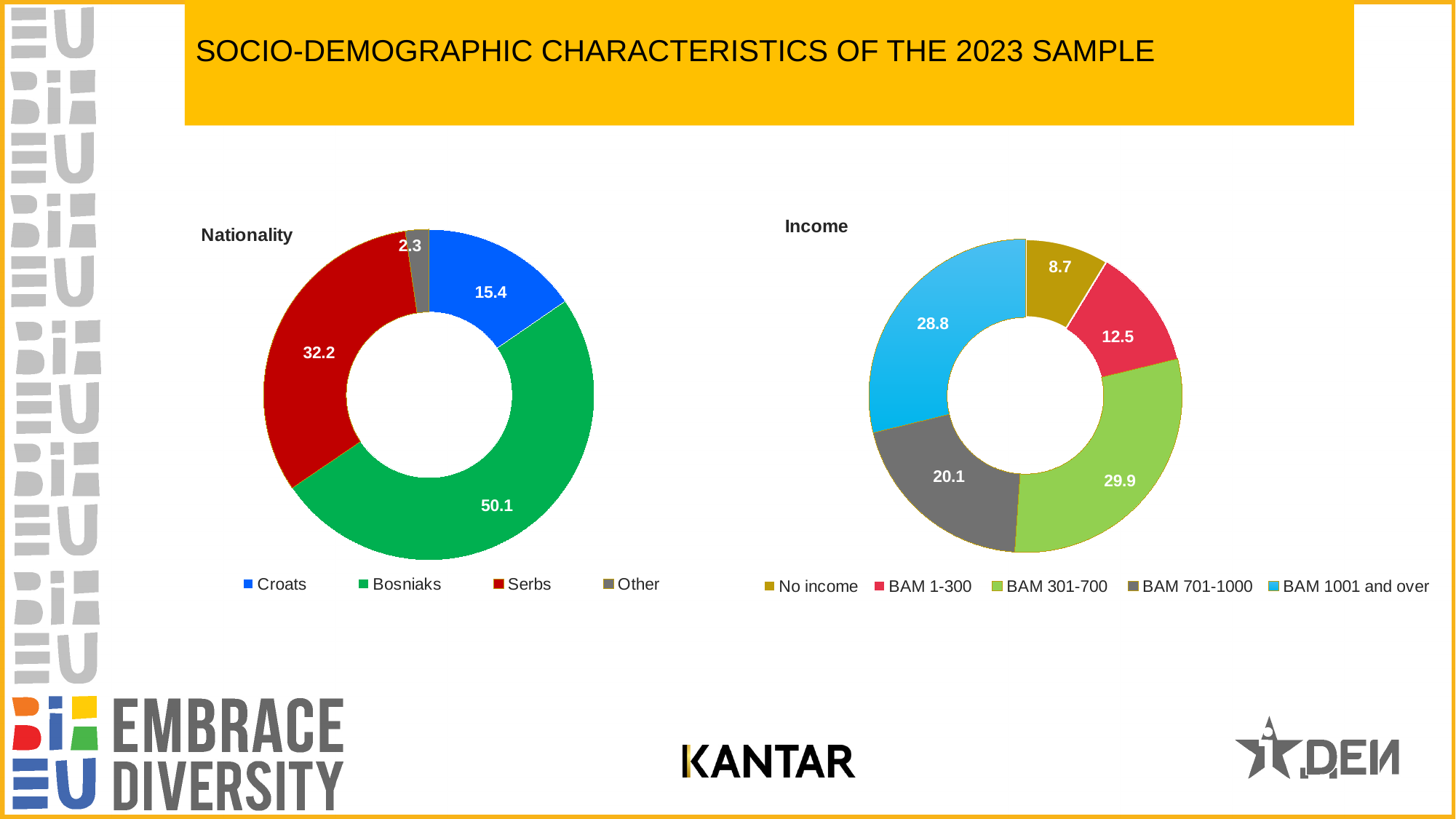
In the Income chart, what is the difference between the values for BAM 301-700 and BAM 701-1000? 9.8 In the Income chart, how many categories does the legend list? 5 In the Income chart, which category has the largest value? BAM 301-700 In the Nationality chart, what is the value for Serbs? 32.2 In the Nationality chart, which category has the smallest value? Other In the Income chart, what is the value for No income? 8.7 In the Nationality chart, how many categories are shown? 4 In the Nationality chart, what is the difference between the values for Serbs and Croats? 16.8 In the Nationality chart, what is the value for Bosniaks? 50.1 In the Income chart, what is the value for BAM 1001 and over? 28.8 What kind of chart is the Income chart? Doughnut (pie) chart In the Income chart, which is larger: BAM 701-1000 or BAM 1-300? BAM 701-1000